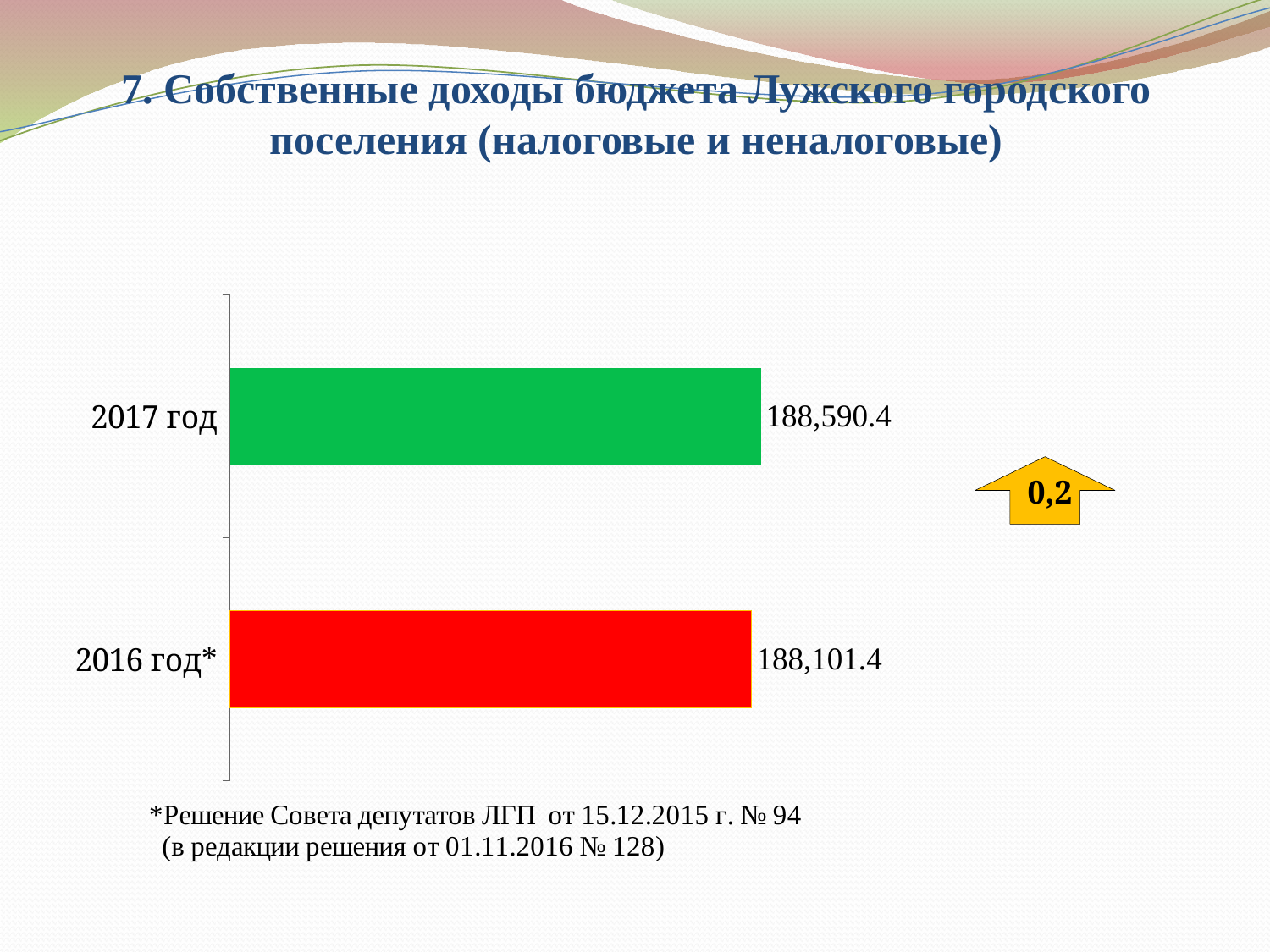
Which year has the higher value, 2017 год or 2016 год*? 2017 год What is the value for 2016 год*? 188,101.4 What is the value for 2017 год? 188,590.4 What kind of chart is shown on the slide? bar chart How many categories are shown in the chart? 2 Which category has the lowest value? 2016 год* Which category has the highest value? 2017 год What number is written inside the yellow arrow next to the chart? 0,2 What is the difference between the values for 2017 год and 2016 год*? 489.0 What colour is the bar for 2016 год*? red